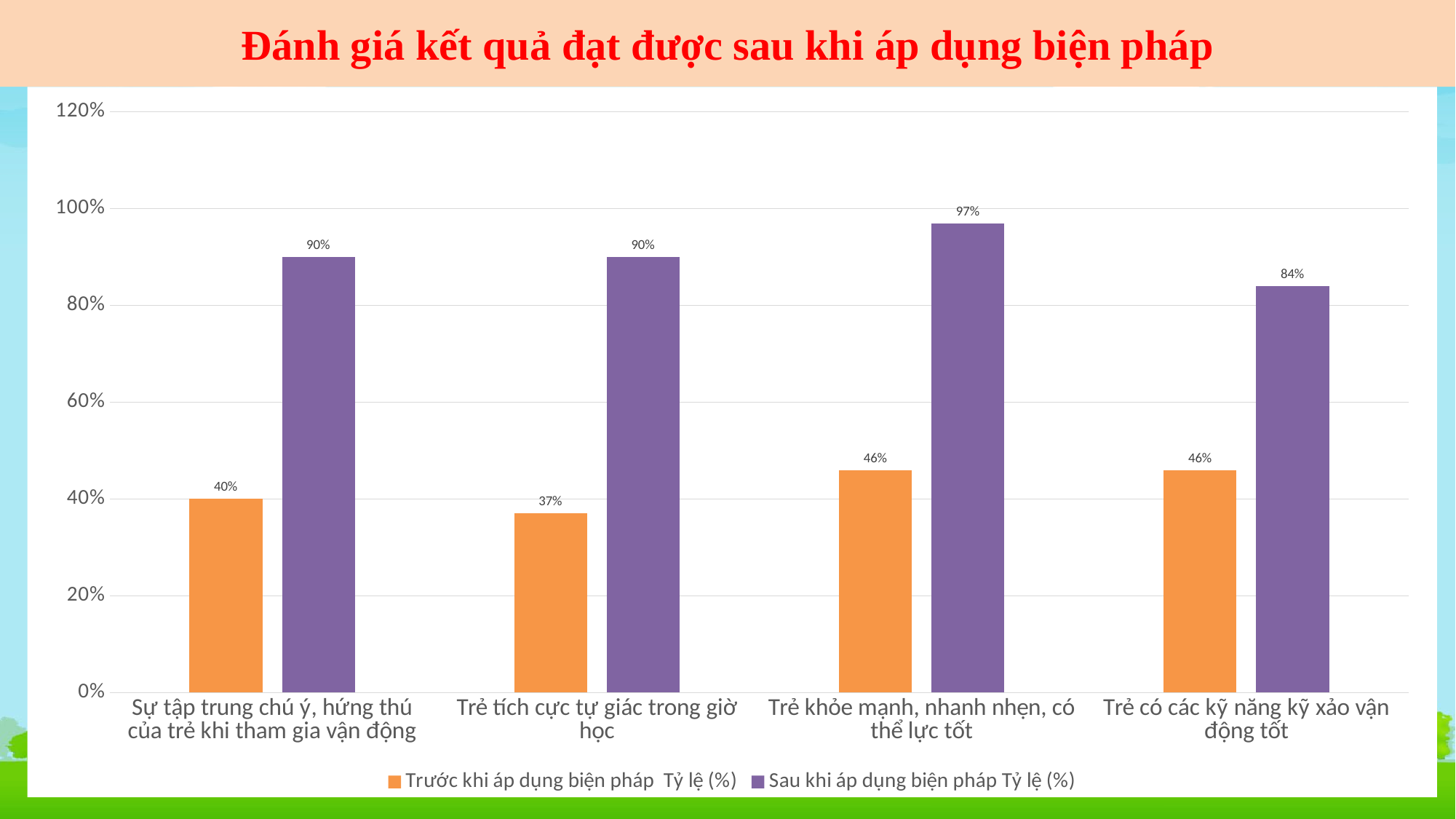
What is the value for "Sau khi áp dụng biện pháp Tỷ lệ (%)" for "Trẻ có các kỹ năng kỹ xảo vận động tốt"? 84% Which is larger: the "Sau khi áp dụng biện pháp" value for "Trẻ khỏe mạnh, nhanh nhẹn, có thể lực tốt" or for "Trẻ có các kỹ năng kỹ xảo vận động tốt"? Trẻ khỏe mạnh, nhanh nhẹn, có thể lực tốt What kind of chart is shown on the slide? bar chart What is the value for "Sau khi áp dụng biện pháp Tỷ lệ (%)" for "Trẻ khỏe mạnh, nhanh nhẹn, có thể lực tốt"? 97% Which category has the lowest value for "Trước khi áp dụng biện pháp Tỷ lệ (%)"? Trẻ tích cực tự giác trong giờ học Is the "Trước khi áp dụng biện pháp" value for "Trẻ có các kỹ năng kỹ xảo vận động tốt" greater or less than 40%? greater What is the title of the chart? Đánh giá kết quả đạt được sau khi áp dụng biện pháp Which category has the highest value for "Sau khi áp dụng biện pháp Tỷ lệ (%)"? Trẻ khỏe mạnh, nhanh nhẹn, có thể lực tốt How many series does the legend list? 2 What is the difference between the "Sau khi áp dụng biện pháp" and "Trước khi áp dụng biện pháp" values for "Sự tập trung chú ý, hứng thú của trẻ khi tham gia vận động"? 50% How many categories are shown on the x axis? 4 What is the value for "Trước khi áp dụng biện pháp Tỷ lệ (%)" for "Trẻ tích cực tự giác trong giờ học"? 37%